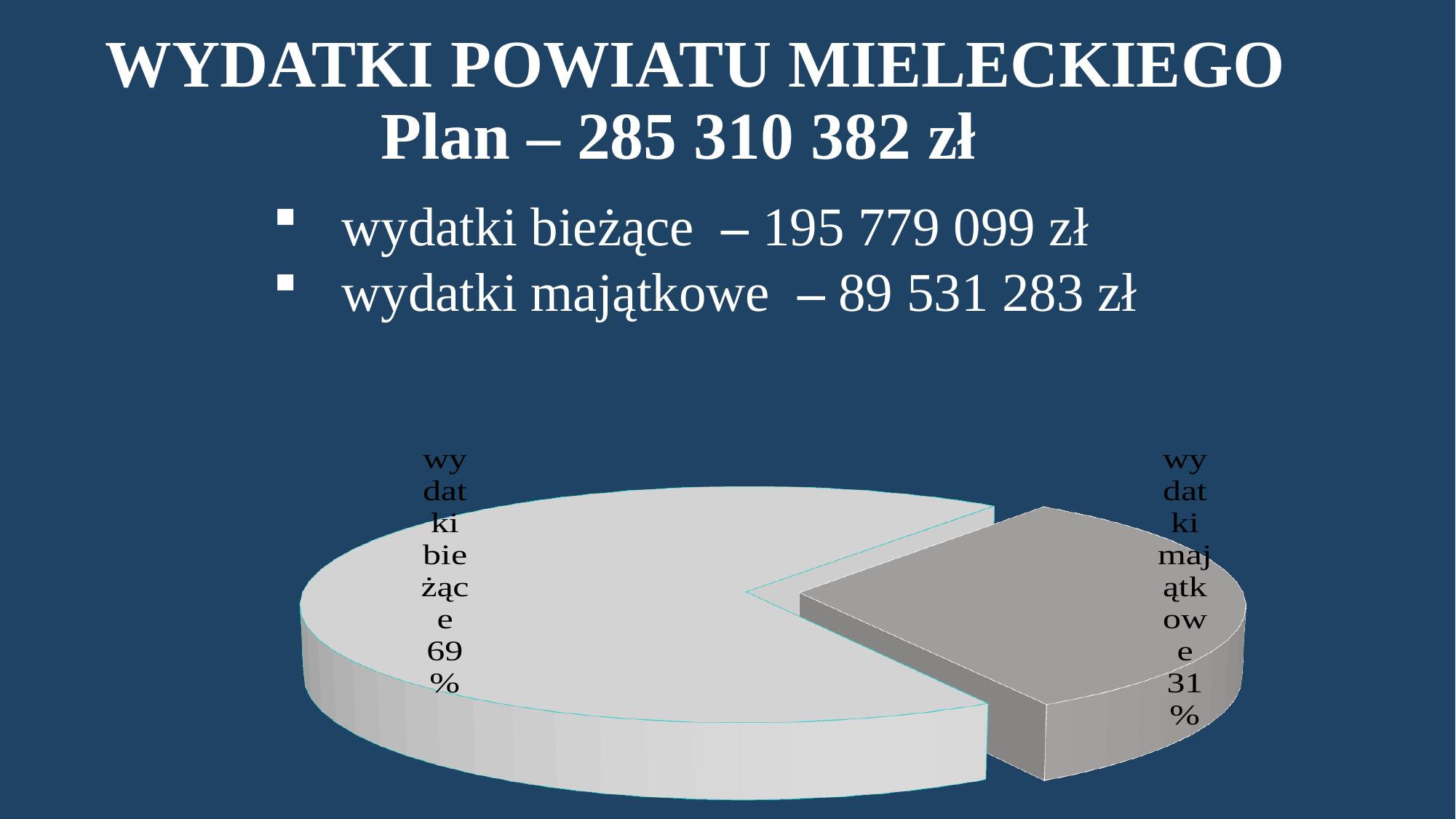
What is the difference in percentage points between the 'wydatki bieżące' slice and the 'wydatki majątkowe' slice? 38 Is the share of 'wydatki majątkowe' greater or less than 50%? less What kind of chart is shown on the slide? pie chart Which slice of the pie chart is the largest? wydatki bieżące Which slice is larger, 'wydatki bieżące' or 'wydatki majątkowe'? wydatki bieżące What share of the pie does the slice 'wydatki majątkowe' represent? 31% What share of the pie does the slice 'wydatki bieżące' represent? 69% Which slice of the pie chart is the smallest? wydatki majątkowe How many slices does the pie chart have? 2 Which slice of the pie chart is shown in the darker grey colour? wydatki majątkowe Which slice of the pie chart is pulled out (exploded) from the rest of the pie? wydatki majątkowe